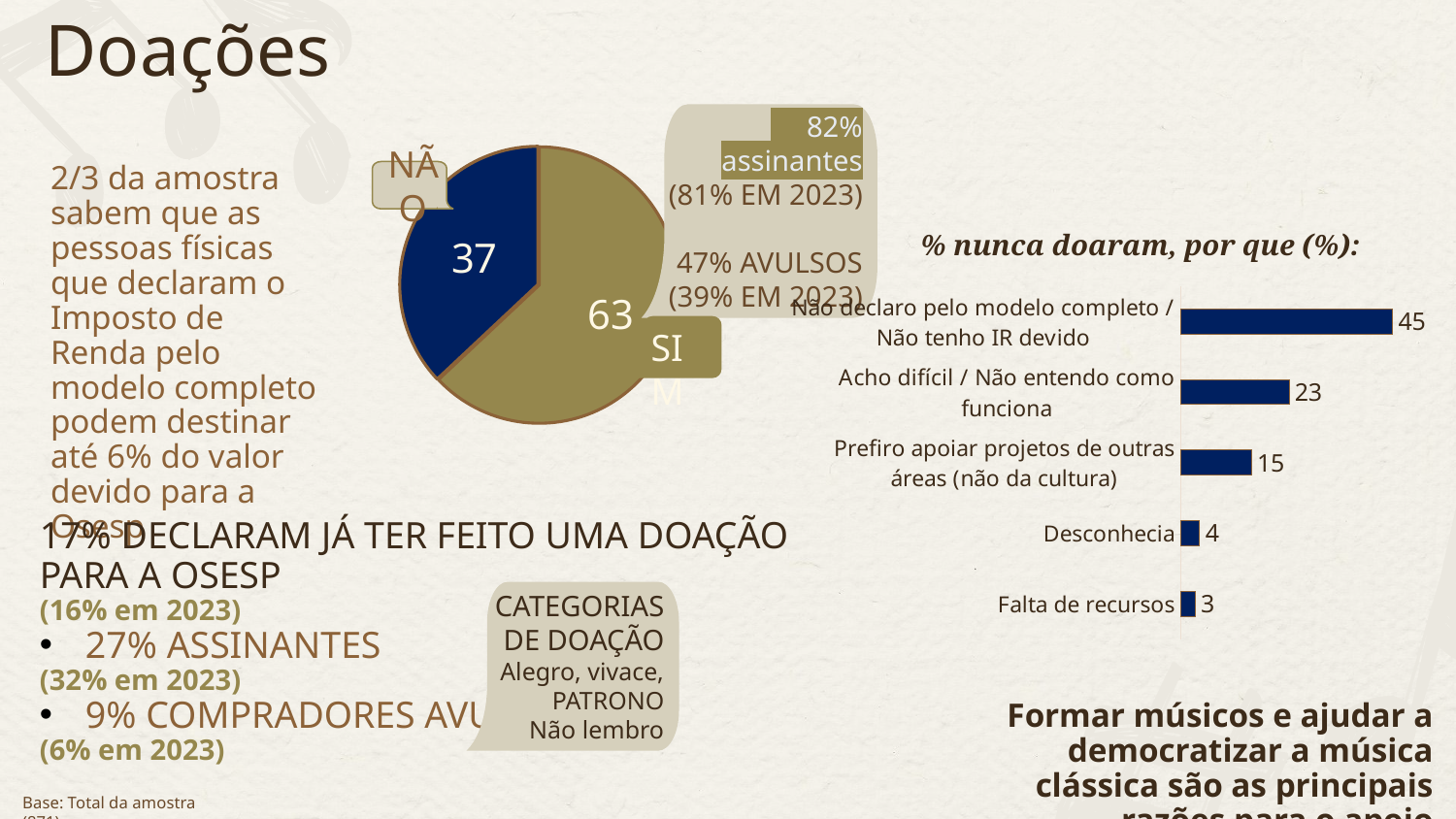
In the bar chart '% nunca doaram, por que (%)', what is the value for 'Acho difícil / Não entendo como funciona'? 23 In the bar chart '% nunca doaram, por que (%)', which category has the highest value? Não declaro pelo modelo completo / Não tenho IR devido How many categories are shown in the bar chart '% nunca doaram, por que (%)'? 5 How many slices does the pie chart have? 2 In the pie chart, what is the difference between the SIM and NÃO values? 26 In the bar chart '% nunca doaram, por que (%)', what is the value for 'Prefiro apoiar projetos de outras áreas (não da cultura)'? 15 What type of chart is the one titled '% nunca doaram, por que (%)'? Bar chart In the pie chart, what value is shown for the NÃO slice? 37 In the pie chart, which slice is larger, SIM or NÃO? SIM In the pie chart, what value is shown for the SIM slice? 63 In the bar chart '% nunca doaram, por que (%)', what is the difference between the values for 'Não declaro pelo modelo completo / Não tenho IR devido' and 'Acho difícil / Não entendo como funciona'? 22 In the bar chart '% nunca doaram, por que (%)', which category has the lowest value? Falta de recursos